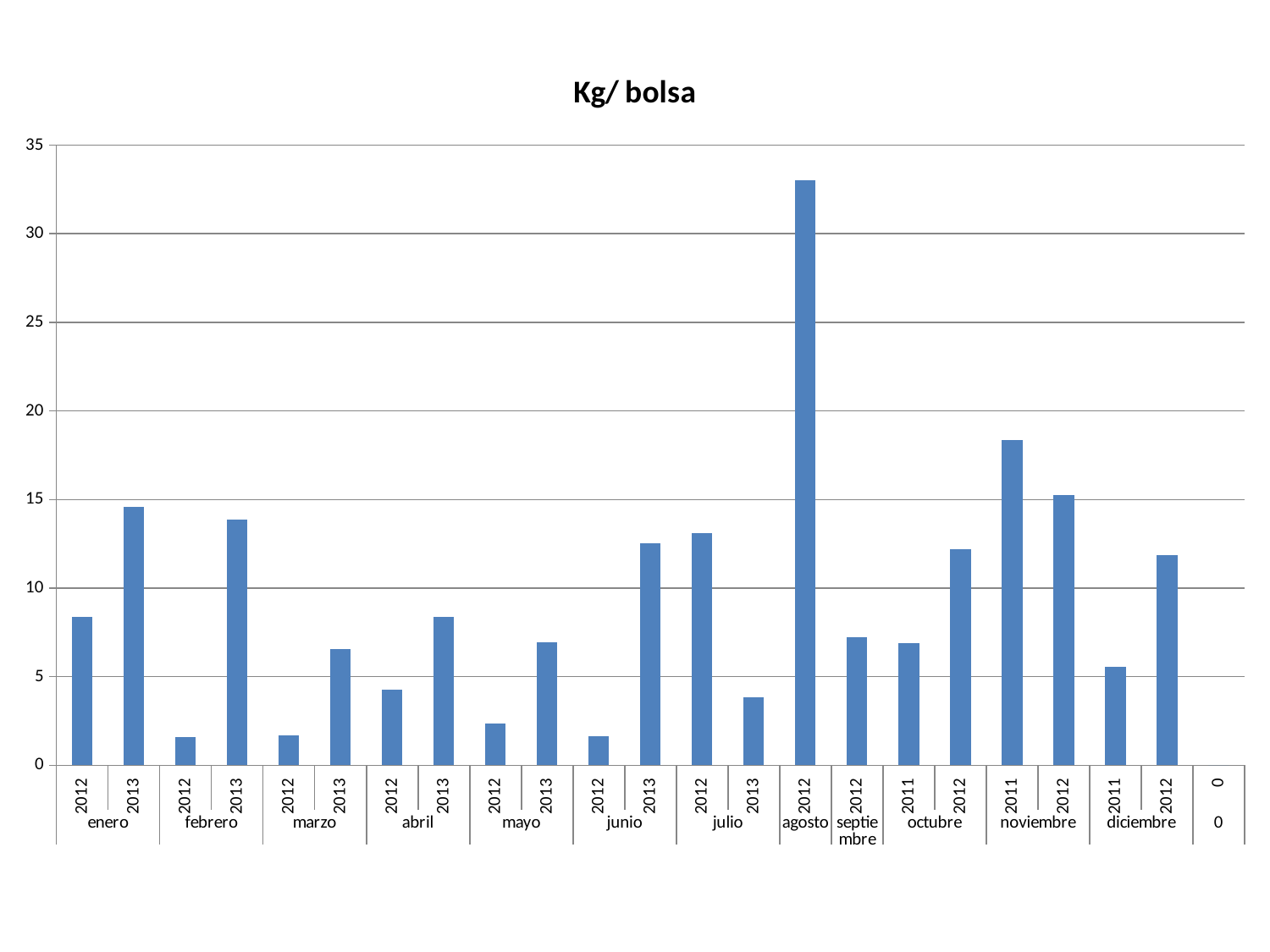
Is the value for julio 2012 greater or less than 10? greater Is the value for mayo 2012 greater or less than 5? less What is the title of the chart? Kg/ bolsa Which is larger, the value for julio 2012 or julio 2013? julio 2012 Which is larger, the value for noviembre 2011 or noviembre 2012? noviembre 2011 Is the value for noviembre 2011 greater or less than 15? greater What type of chart is shown on the slide? bar chart What is the maximum value shown on the vertical axis? 35 Which bar has the highest value in the chart? agosto 2012 Which is larger, the value for enero 2012 or enero 2013? enero 2013